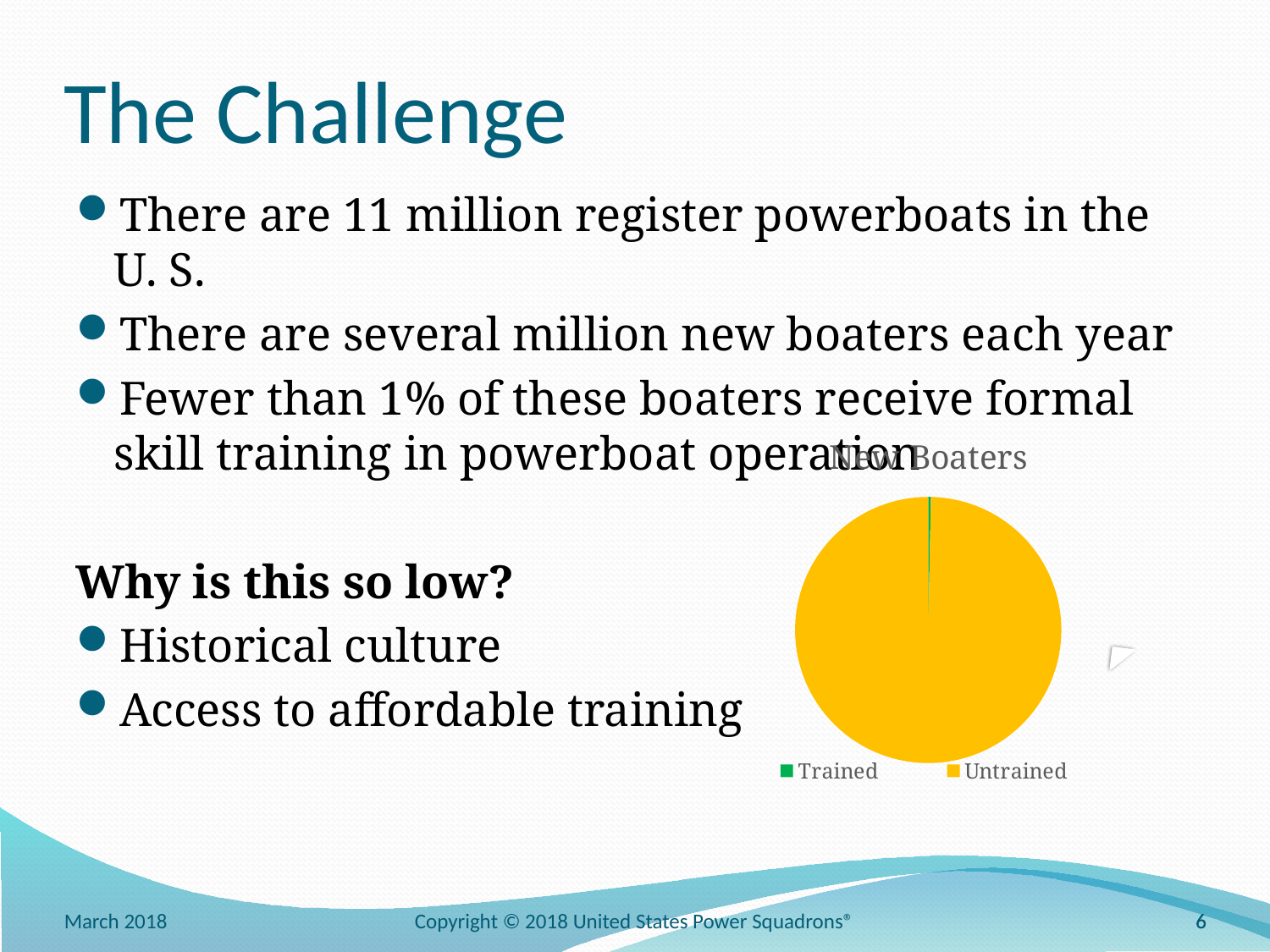
What is the title of the pie chart? New Boaters What kind of chart is shown on the slide? pie chart What colour represents the Untrained category in the pie chart? yellow How many slices does the pie chart have? 2 In the pie chart, which slice is larger, Trained or Untrained? Untrained How many categories does the pie chart's legend list? 2 Which category has the largest slice in the pie chart? Untrained Which category has the smallest slice in the pie chart? Trained